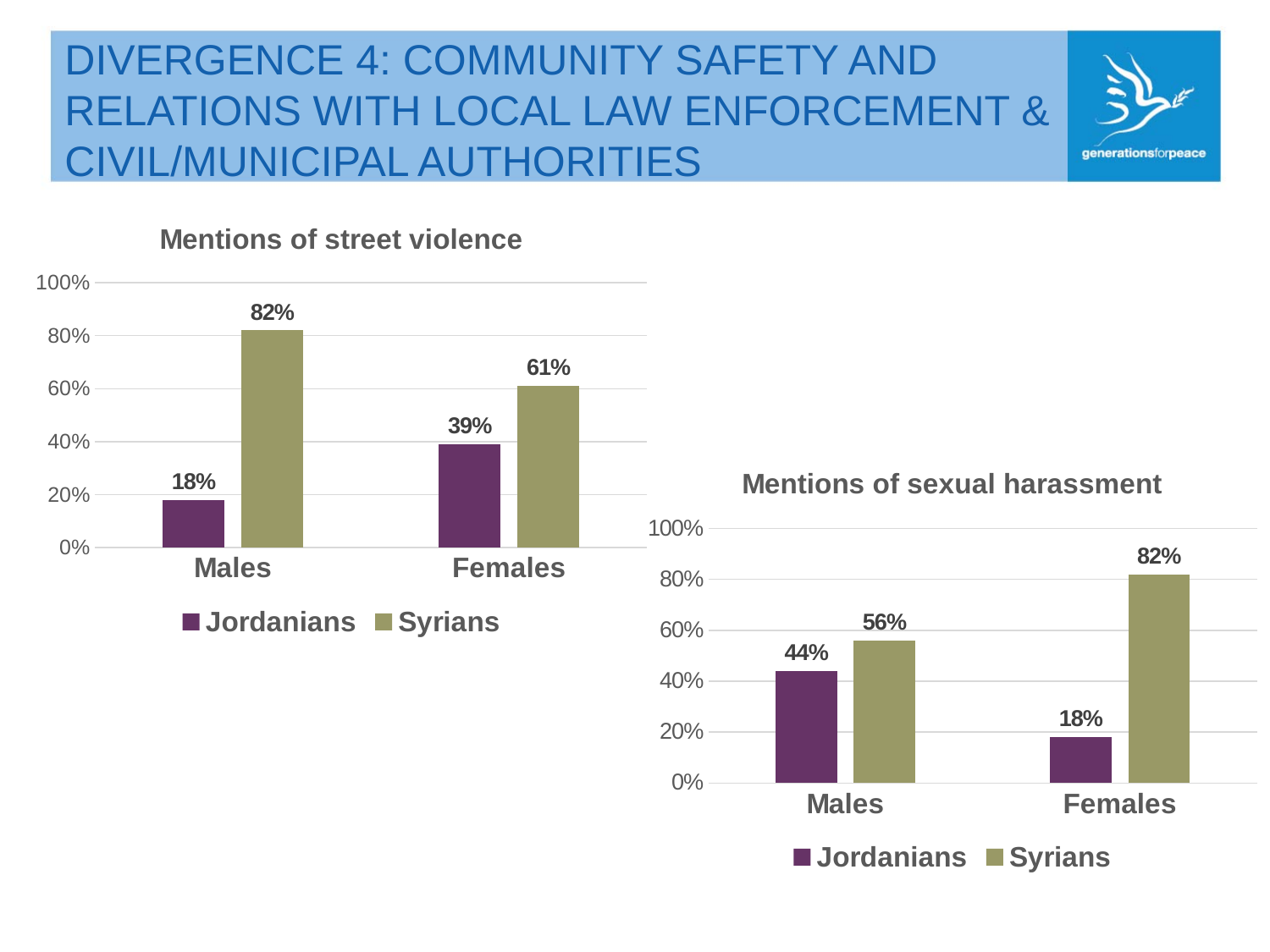
In the 'Mentions of street violence' chart, which colour represents Syrians? Olive green In the 'Mentions of sexual harassment' chart, which group has the highest value? Syrian females How many series does the legend of the 'Mentions of street violence' chart list? 2 In the 'Mentions of street violence' chart, what is the value for Syrian males? 82% In the 'Mentions of street violence' chart, what is the value for Jordanian females? 39% What kind of chart is the 'Mentions of sexual harassment' chart? Bar chart In the 'Mentions of street violence' chart, which group has the lowest value? Jordanian males In the 'Mentions of sexual harassment' chart, what is the difference between Syrian females and Jordanian females? 64% In the 'Mentions of sexual harassment' chart, which is larger: the value for Jordanian males or Syrian males? Syrian males In the 'Mentions of sexual harassment' chart, what is the value for Jordanian males? 44% In the 'Mentions of street violence' chart, what is the difference between Syrian males and Jordanian males? 64% In the 'Mentions of sexual harassment' chart, what is the value for Syrian females? 82%